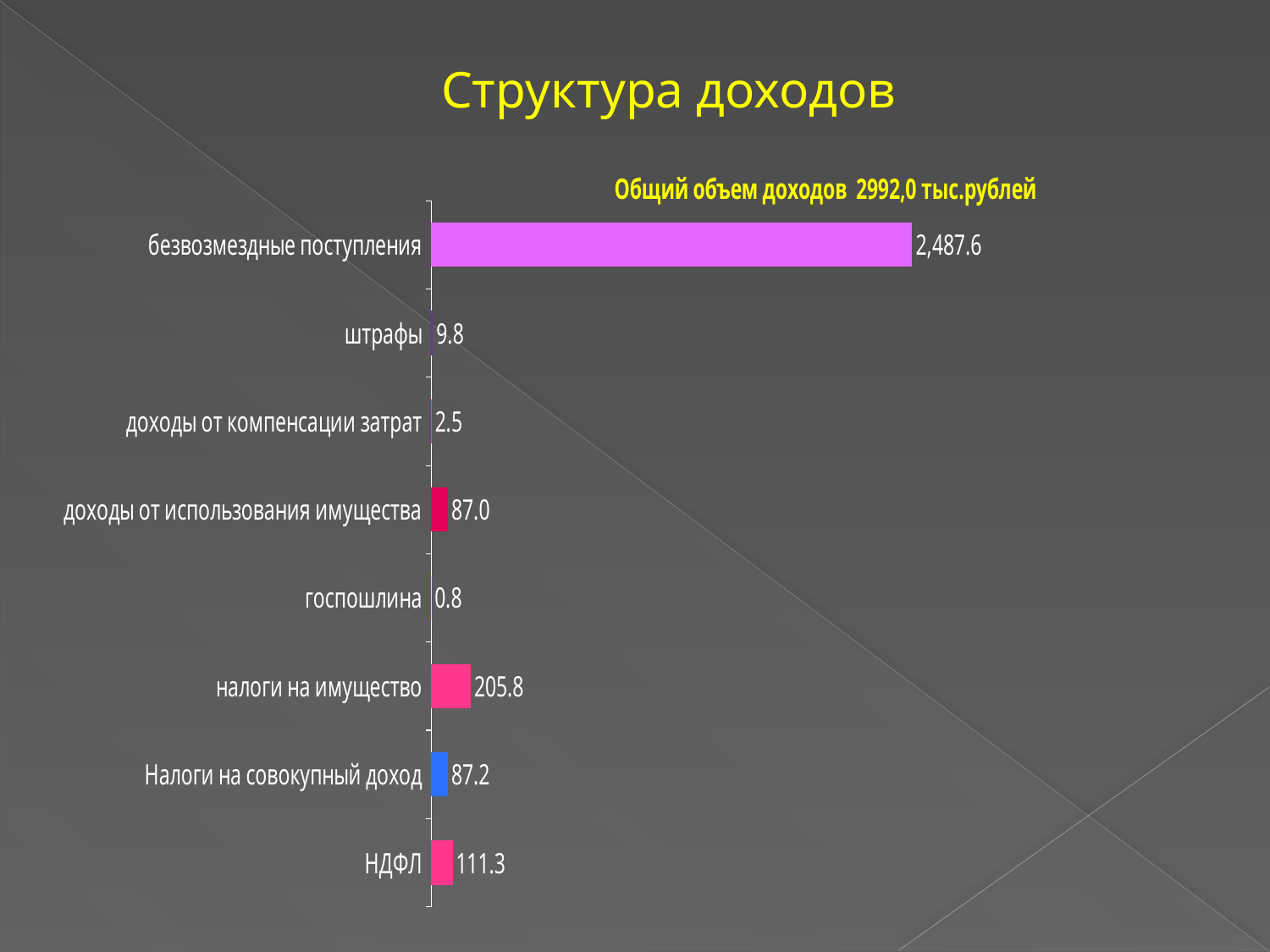
What is the value for штрафы? 9.8 What is the difference between налоги на имущество and НДФЛ? 94.5 What is the value for налоги на имущество? 205.8 What is the difference between НДФЛ and Налоги на совокупный доход? 24.1 Which category has the lowest value? госпошлина How many categories are shown in the chart? 8 What is the value for госпошлина? 0.8 What is the value for НДФЛ? 111.3 What is the value for безвозмездные поступления? 2,487.6 What kind of chart is shown on the slide? bar chart Which category has the highest value? безвозмездные поступления Which is larger, налоги на имущество or НДФЛ? налоги на имущество